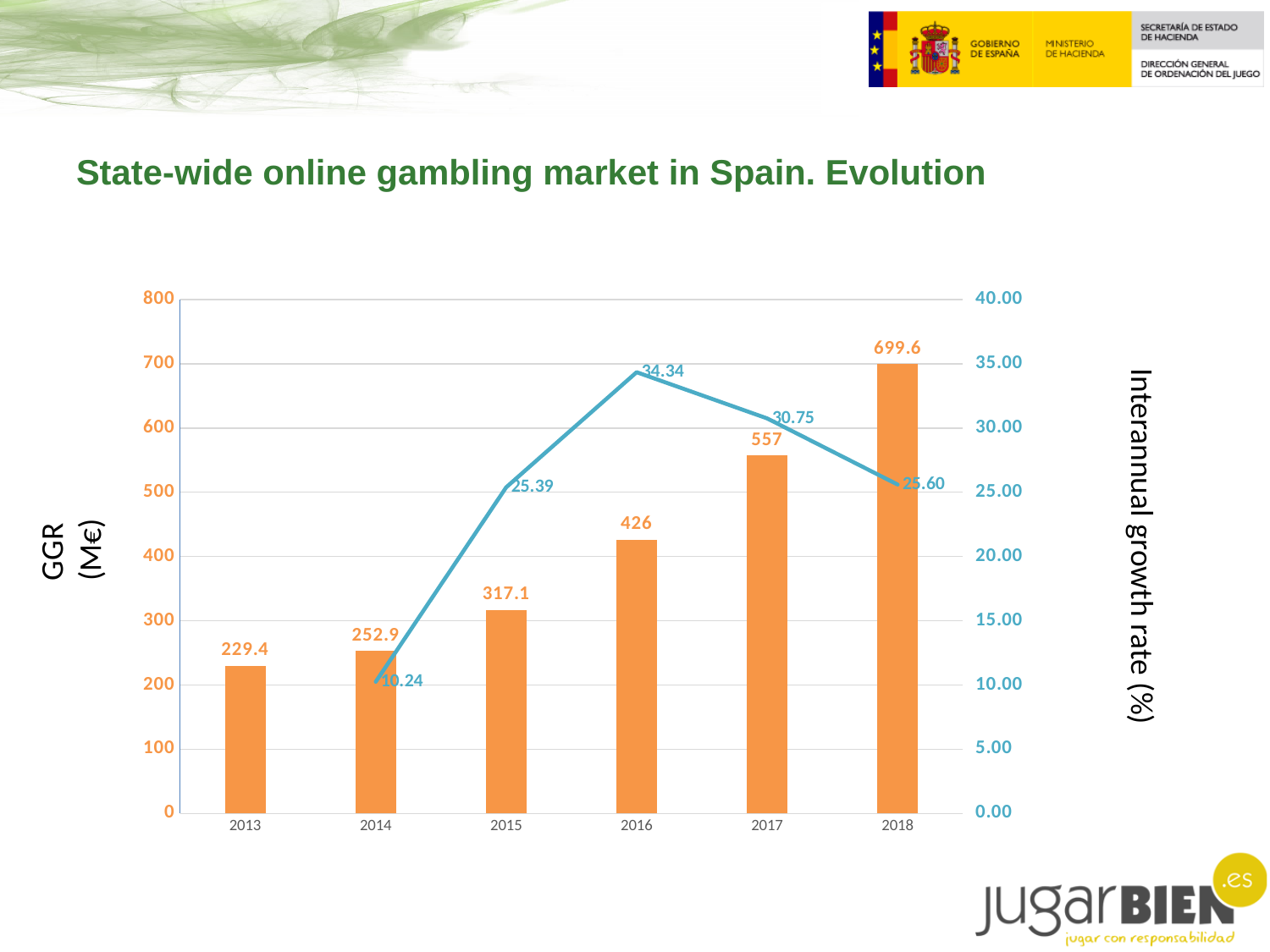
What is the title of the right-hand vertical axis? Interannual growth rate (%) Which year has the highest GGR (M€)? 2018 How many years are shown on the x axis? 6 What is the interannual growth rate (%) shown for 2014? 10.24 Which is larger, the interannual growth rate for 2017 or for 2018? 2017 What is the interannual growth rate (%) shown for 2016? 34.34 Do the GGR (M€) bars rise or fall from 2013 to 2018? rise What is the GGR (M€) value for 2013? 229.4 What is the difference in GGR (M€) between 2018 and 2017? 142.6 What is the GGR (M€) value for 2016? 426 What kind of chart is used to show GGR (M€)? bar chart Which year has the lowest interannual growth rate (%) on the line? 2014